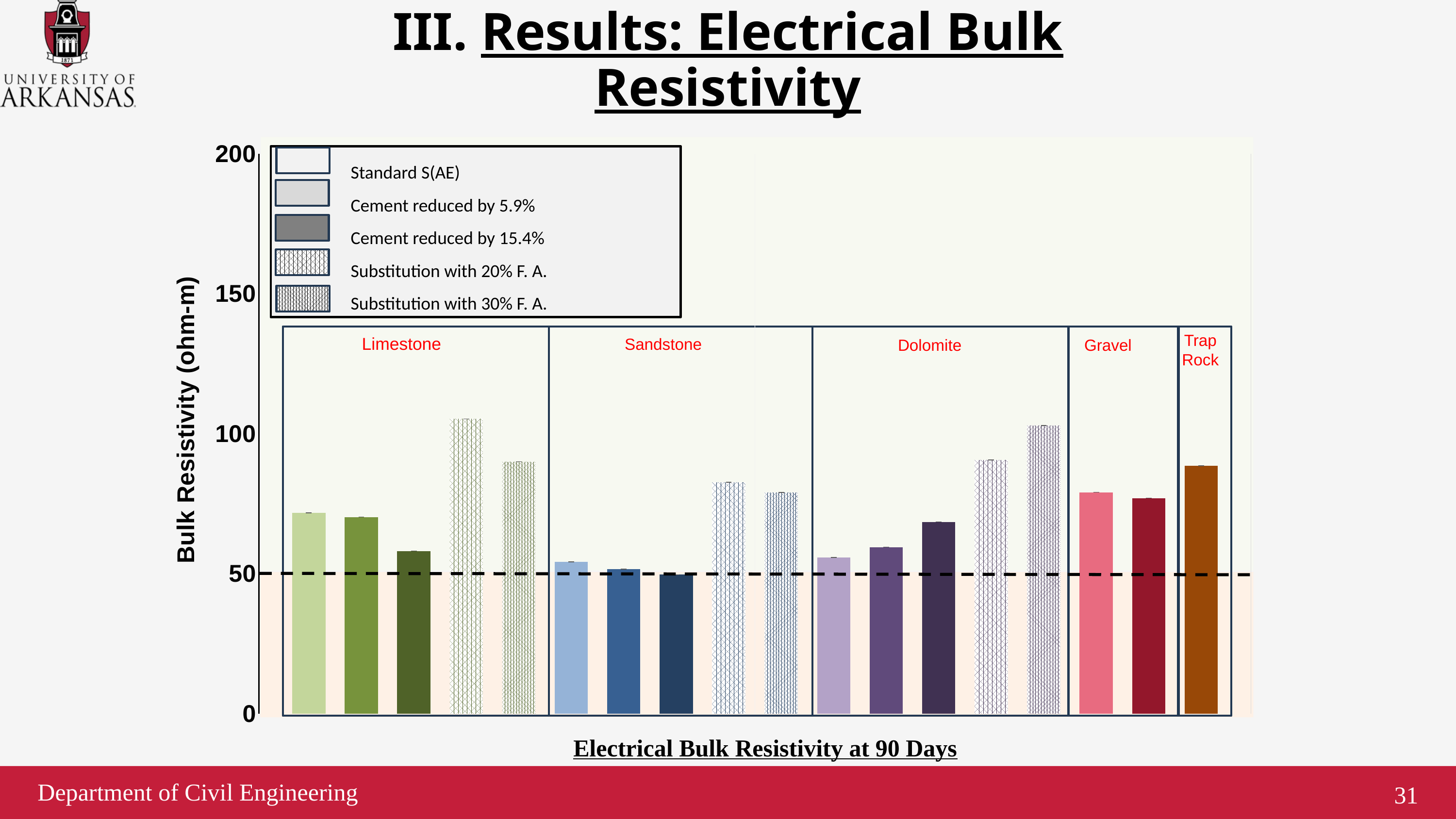
Which is larger, the Standard S(AE) value for Limestone or the Standard S(AE) value for Sandstone? Limestone How many aggregate types (groups) are labelled on the chart? 5 Within the Limestone group, which series has the highest bar? Substitution with 20% F. A. What is the label of the y axis? Bulk Resistivity (ohm-m) How many series does the legend list? 5 Within the Dolomite group, which series has the highest bar? Substitution with 30% F. A. Within the Limestone group, which series has the lowest bar? Cement reduced by 15.4% Is the Substitution with 20% F. A. value for Sandstone greater or less than 100? less What kind of chart is shown on the slide? bar chart What is the title printed below the chart? Electrical Bulk Resistivity at 90 Days Is the value for Trap Rock greater or less than 100? less Is the Standard S(AE) value for Limestone greater or less than 50? greater